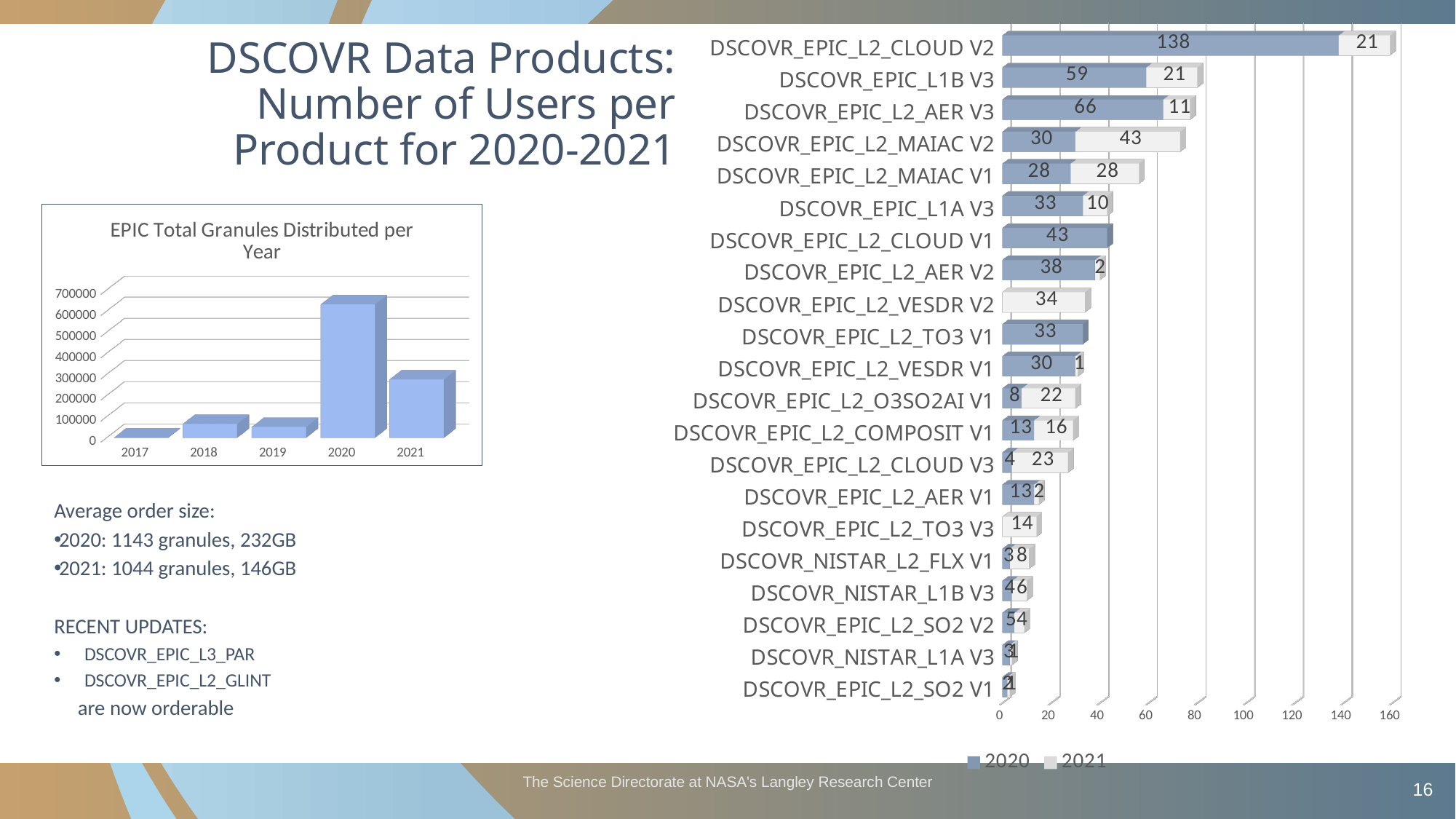
What kind of chart is 'EPIC Total Granules Distributed per Year'? bar chart In the chart on the right, what is the difference between the 2020 and 2021 user counts for DSCOVR_EPIC_L1B V3? 38 In the chart on the right, did DSCOVR_EPIC_L2_MAIAC V2 have more users in 2020 or in 2021? 2021 How many years are shown in the 'EPIC Total Granules Distributed per Year' chart? 5 In the 'EPIC Total Granules Distributed per Year' chart, which year has the highest value? 2020 In the chart on the right, how many users did DSCOVR_EPIC_L2_CLOUD V2 have in 2020? 138 In the 'EPIC Total Granules Distributed per Year' chart, is the value for 2020 greater or less than 500000? greater How many series does the legend of the chart on the right list? 2 How many products are listed in the chart on the right? 21 In the chart on the right, how many users did DSCOVR_EPIC_L2_MAIAC V2 have in 2021? 43 In the chart on the right, which product had the most users in 2020? DSCOVR_EPIC_L2_CLOUD V2 In the chart on the right, what is the total number of users (2020 plus 2021) for DSCOVR_EPIC_L2_CLOUD V2? 159